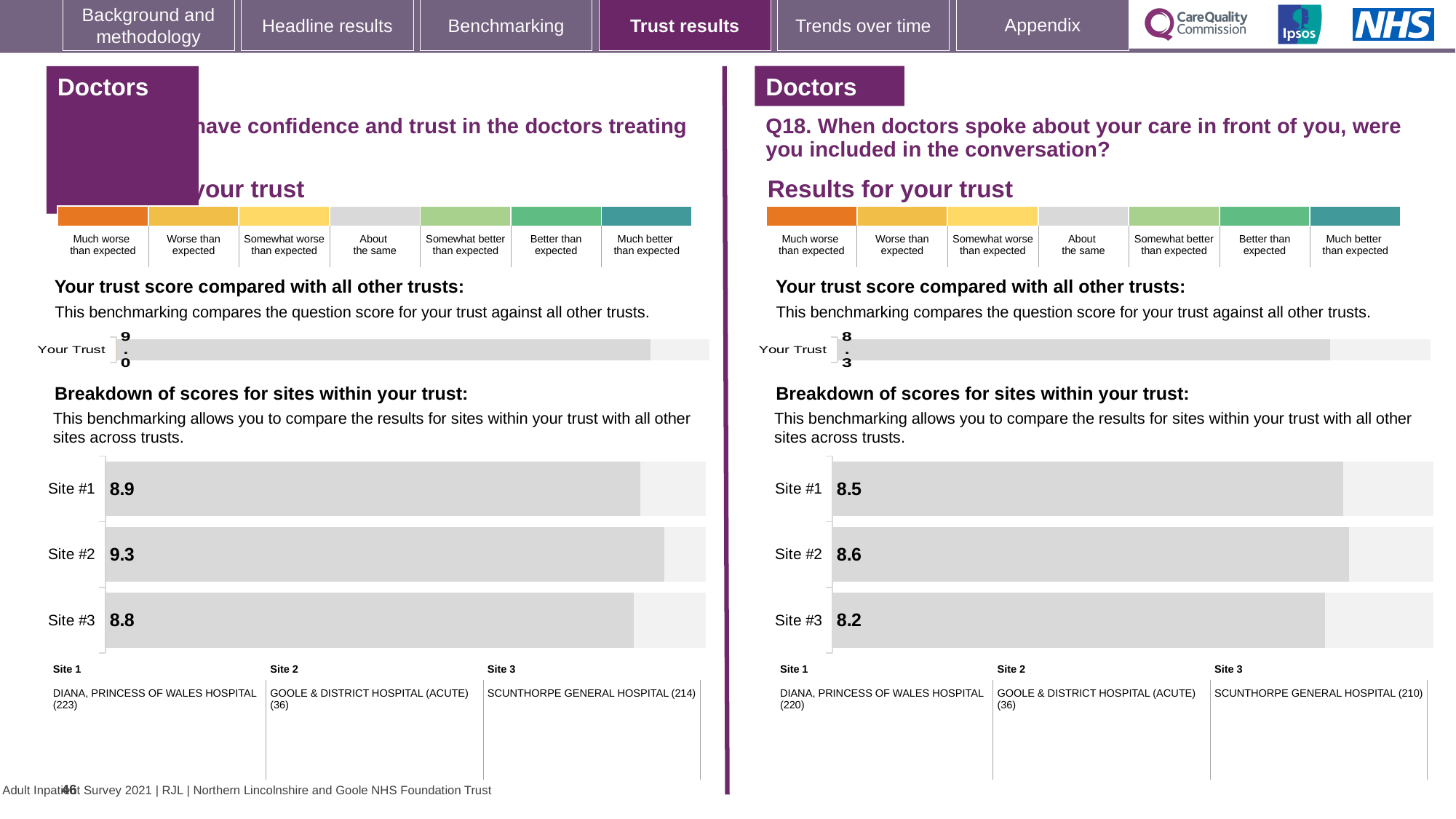
In the left-hand 'Your trust score compared with all other trusts' chart, what is the score shown for Your Trust? 9.0 In the Q18 site breakdown chart, which hospital is listed as Site 3? SCUNTHORPE GENERAL HOSPITAL (210) In the Q18 'Breakdown of scores for sites within your trust' chart, what is the difference between the scores for Site #1 and Site #3? 0.3 In the Q18 'Breakdown of scores for sites within your trust' chart, what is the score for Site #3? 8.2 Which is larger: the Site #1 score in the left-hand site breakdown chart or the Site #1 score in the Q18 site breakdown chart? The left-hand chart (8.9) How many sites are shown in the Q18 'Breakdown of scores for sites within your trust' chart? 3 In the Q18 'Breakdown of scores for sites within your trust' chart, which site has the highest score? Site #2 In the left-hand 'Breakdown of scores for sites within your trust' chart, what is the score for Site #2? 9.3 In the left-hand 'Breakdown of scores for sites within your trust' chart, what is the difference between the scores for Site #2 and Site #3? 0.5 In the Q18 'Your trust score compared with all other trusts' chart, what is the score shown for Your Trust? 8.3 In the left-hand 'Breakdown of scores for sites within your trust' chart, which site has the lowest score? Site #3 What type of chart is used for the 'Breakdown of scores for sites within your trust' on the left-hand side of the slide? Bar chart